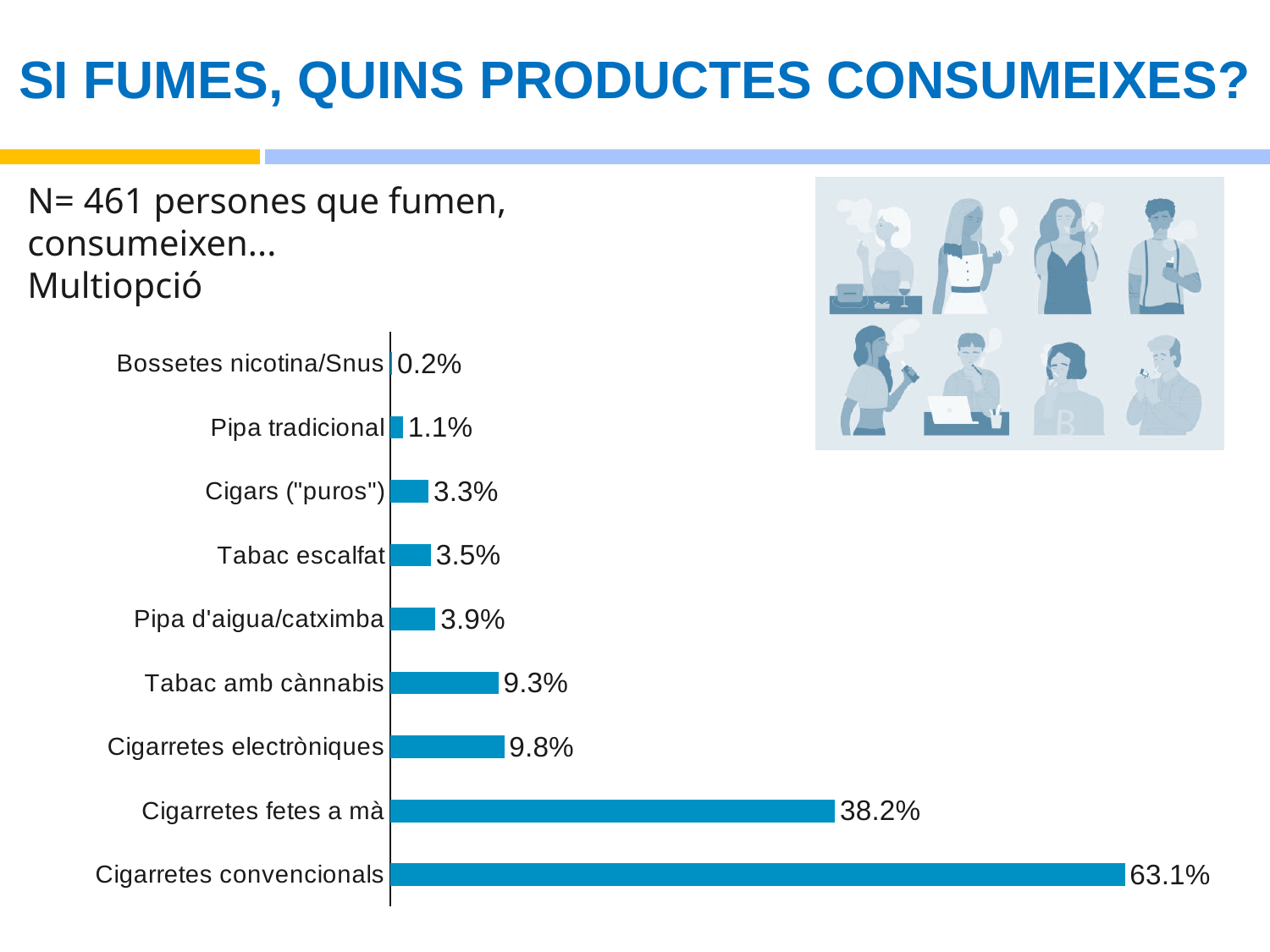
How many categories are shown in the chart? 9 Which category has the lowest value? Bossetes nicotina/Snus Which category has the highest value? Cigarretes convencionals What is the value for Cigarretes convencionals? 63.1% What is the difference between the values for Cigarretes convencionals and Cigarretes fetes a mà? 24.9% What is the value for Tabac amb cànnabis? 9.3% What kind of chart is shown on the slide? Bar chart What is the value for Cigarretes fetes a mà? 38.2% What is the value for Pipa d'aigua/catximba? 3.9% What is the difference between the values for Cigarretes electròniques and Tabac amb cànnabis? 0.5% Which is larger, the value for Cigars ("puros") or the value for Pipa tradicional? Cigars ("puros") What is the title of the slide containing the chart? SI FUMES, QUINS PRODUCTES CONSUMEIXES?